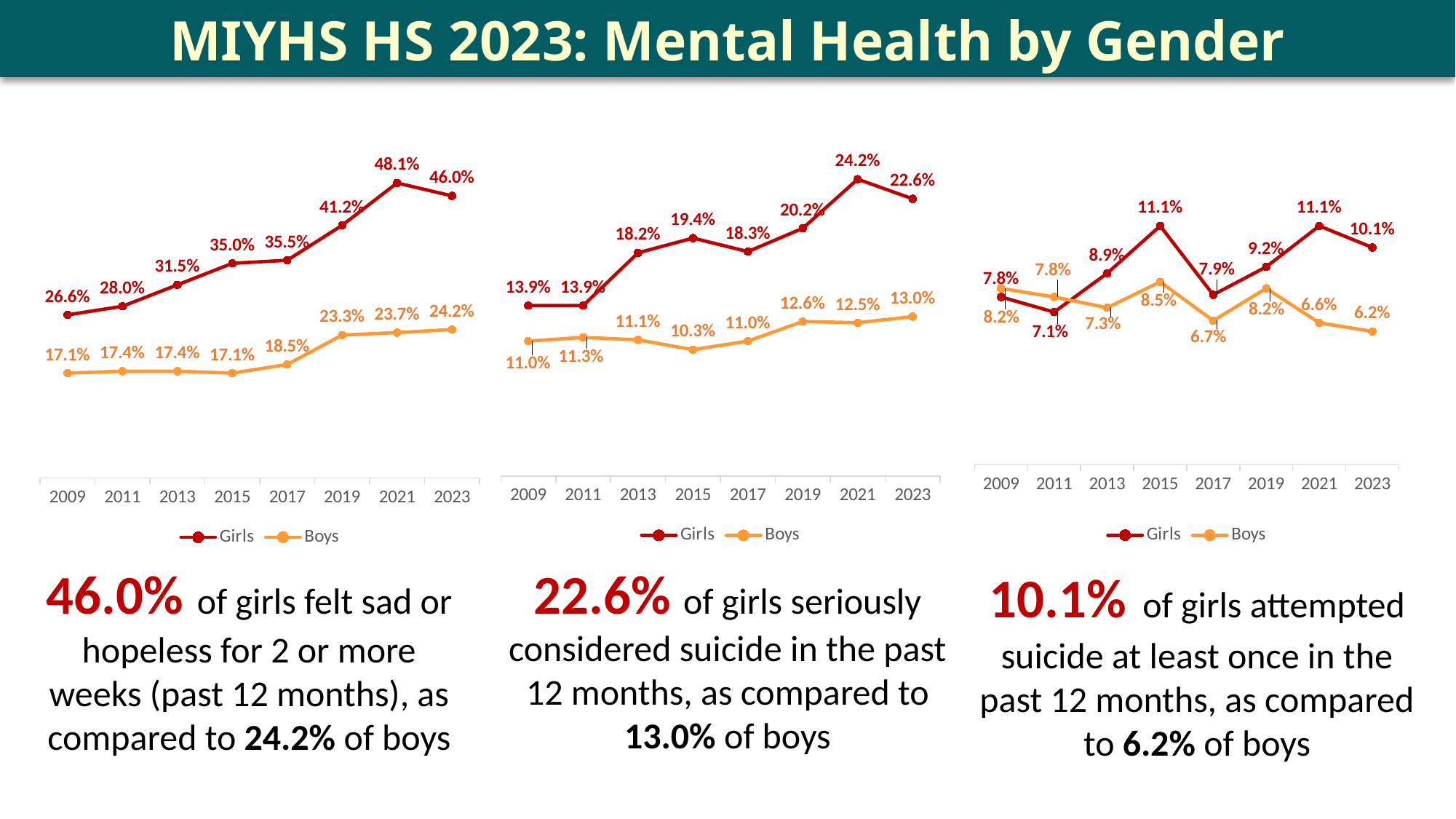
In the left chart, what is the value for Boys in 2023? 24.2% In the left chart, what is the value for Girls in 2021? 48.1% How many years are shown on the x axis of the left chart? 8 In the left chart, which year has the highest value for Girls? 2021 In the right chart, what is the value for Boys in 2017? 6.7% In the left chart, does the Girls line generally rise or fall from 2009 to 2021? Rise What kind of chart is the right chart? Line chart In the middle chart, what is the difference between Girls and Boys in 2023? 9.6% In the right chart, which is larger in 2009, the value for Girls or the value for Boys? Boys In the middle chart, what is the value for Girls in 2015? 19.4% In the right chart, which year has the lowest value for Boys? 2023 How many series does the legend of the middle chart list? 2